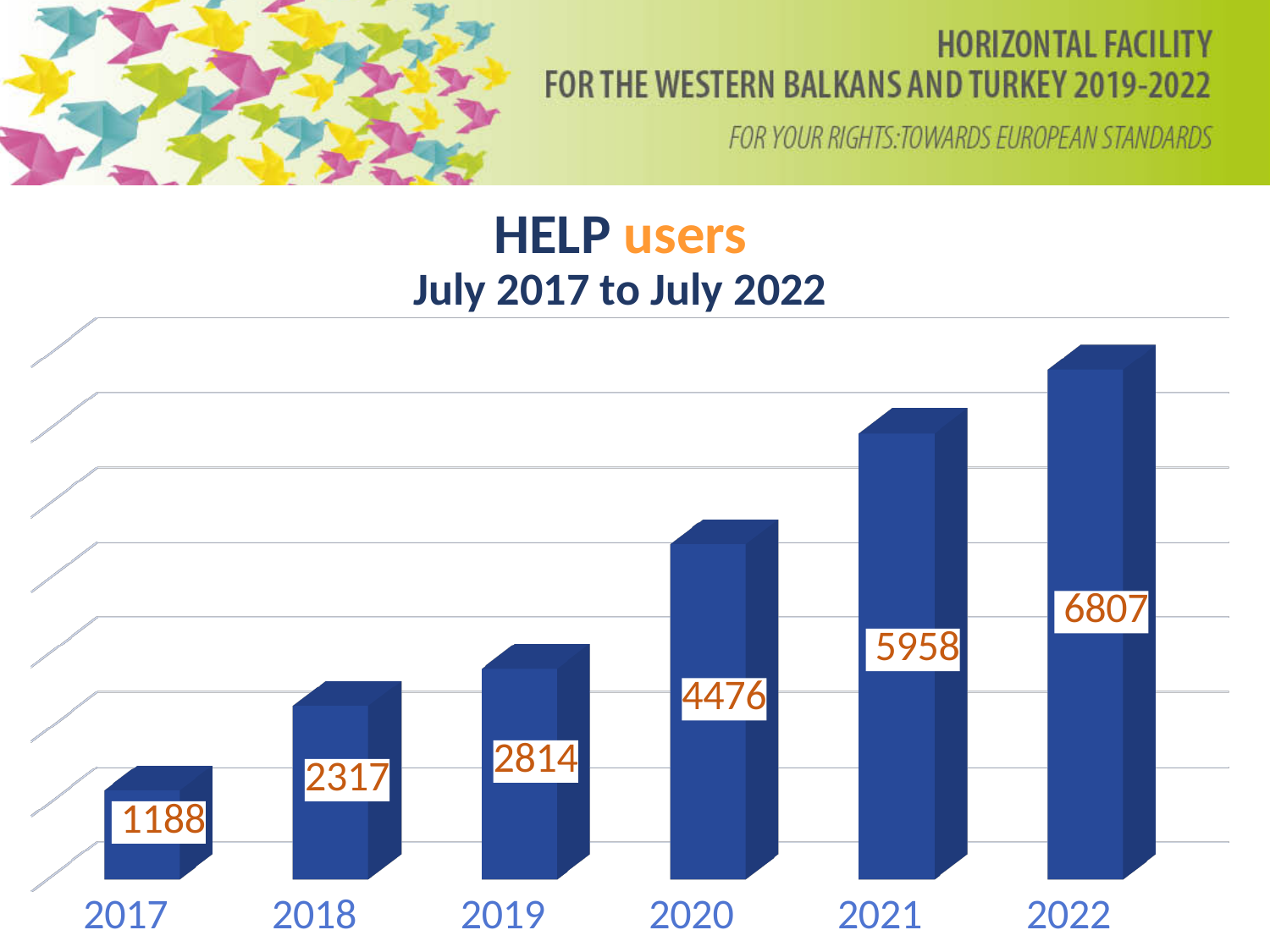
Which year has the lowest number of HELP users? 2017 What period does the chart subtitle say the data covers? July 2017 to July 2022 What is the number of HELP users in 2021? 5958 Which year has the highest number of HELP users? 2022 How many years are shown on the chart? 6 What is the difference in HELP users between 2020 and 2019? 1662 Which year has more HELP users, 2018 or 2020? 2020 What is the number of HELP users in 2019? 2814 What is the difference in HELP users between 2022 and 2021? 849 What is the number of HELP users in 2017? 1188 Do the HELP user numbers rise or fall from 2017 to 2022? Rise What kind of chart is shown on the slide? Bar chart